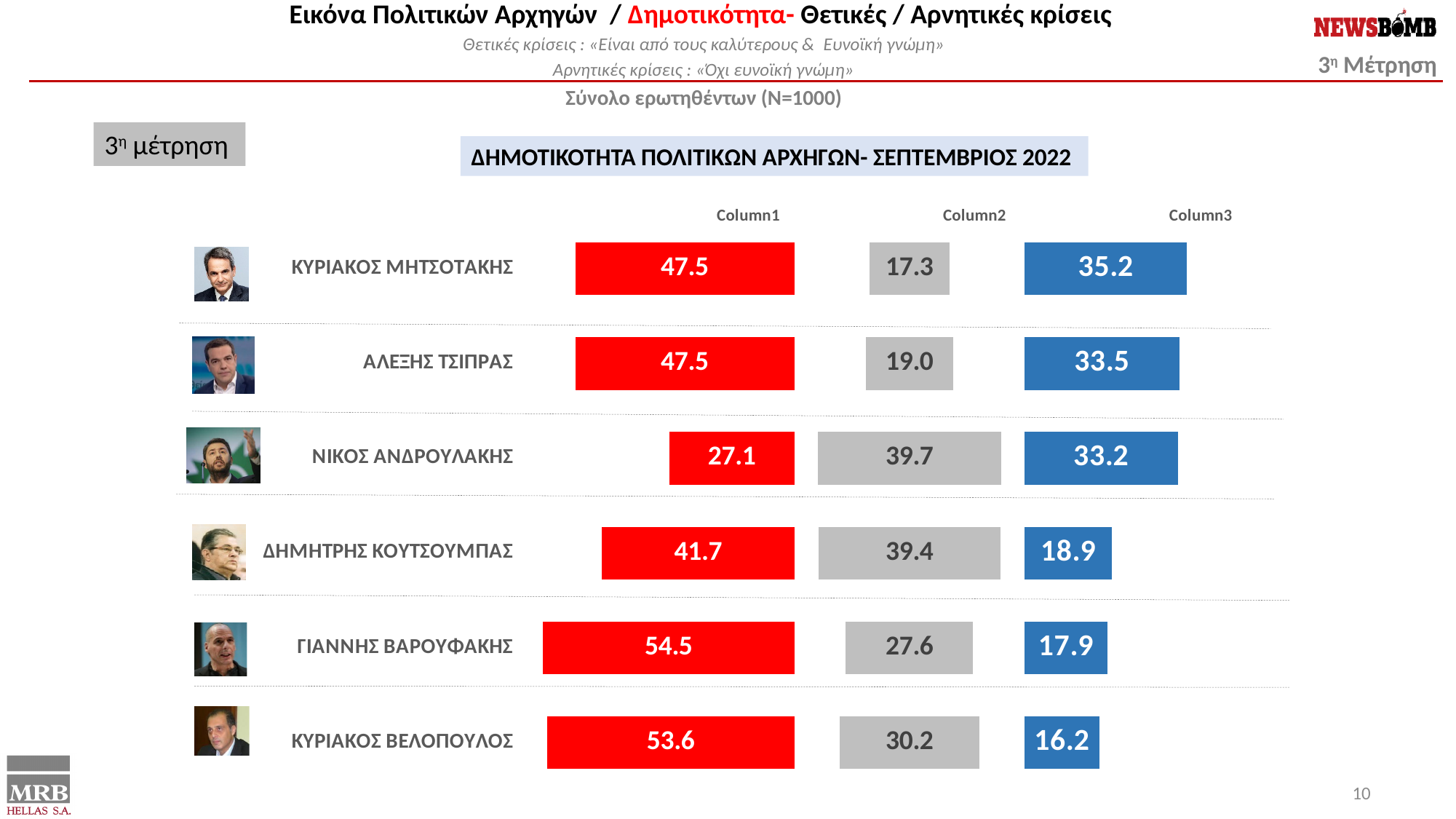
What is the difference between the Column1 values of ΓΙΑΝΝΗΣ ΒΑΡΟΥΦΑΚΗΣ and ΚΥΡΙΑΚΟΣ ΒΕΛΟΠΟΥΛΟΣ? 0.9 Which politician has the lowest Column3 value? ΚΥΡΙΑΚΟΣ ΒΕΛΟΠΟΥΛΟΣ What is the Column2 value for ΑΛΕΞΗΣ ΤΣΙΠΡΑΣ? 19.0 Which politician has the lowest Column1 value? ΝΙΚΟΣ ΑΝΔΡΟΥΛΑΚΗΣ Which is larger: the Column3 value for ΔΗΜΗΤΡΗΣ ΚΟΥΤΣΟΥΜΠΑΣ or the Column3 value for ΝΙΚΟΣ ΑΝΔΡΟΥΛΑΚΗΣ? ΝΙΚΟΣ ΑΝΔΡΟΥΛΑΚΗΣ How many series does the chart show? 3 Which politician has the highest Column1 value? ΓΙΑΝΝΗΣ ΒΑΡΟΥΦΑΚΗΣ How many politicians are shown in the chart? 6 What type of chart is shown on the slide? Bar chart What is the Column3 value for ΚΥΡΙΑΚΟΣ ΜΗΤΣΟΤΑΚΗΣ? 35.2 What is the Column1 value for ΓΙΑΝΝΗΣ ΒΑΡΟΥΦΑΚΗΣ? 54.5 What is the Column2 value for ΝΙΚΟΣ ΑΝΔΡΟΥΛΑΚΗΣ? 39.7